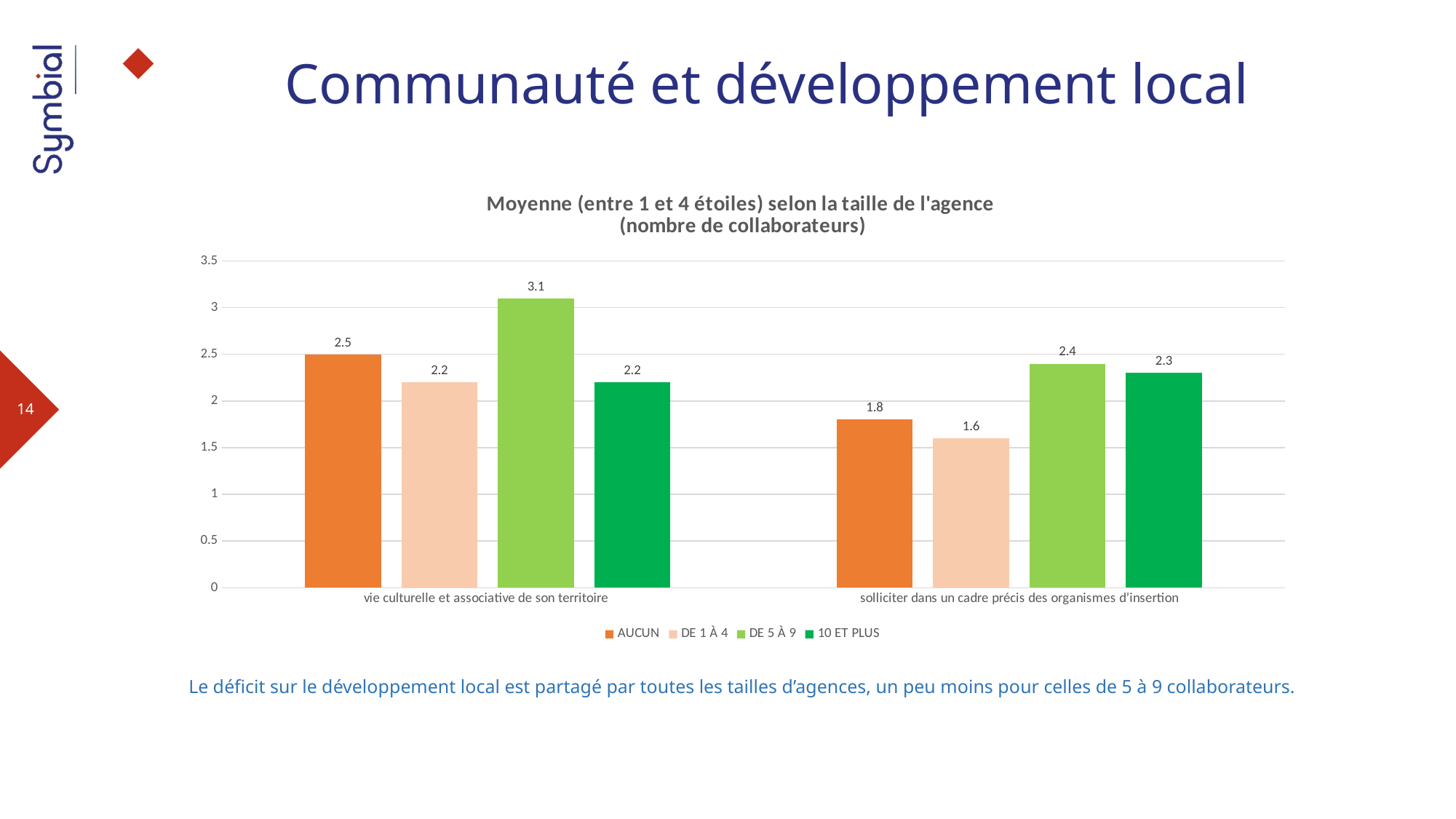
How many series does the legend list? 4 Which is larger: the AUCUN value for 'vie culturelle et associative de son territoire' or the AUCUN value for 'solliciter dans un cadre précis des organismes d'insertion'? vie culturelle et associative de son territoire What is the value for DE 1 À 4 in the category 'solliciter dans un cadre précis des organismes d'insertion'? 1.6 What is the title of the chart? Moyenne (entre 1 et 4 étoiles) selon la taille de l'agence (nombre de collaborateurs) How many categories are shown on the x axis? 2 Which series has the lowest value in the category 'solliciter dans un cadre précis des organismes d'insertion'? DE 1 À 4 Is the value for DE 5 À 9 in 'vie culturelle et associative de son territoire' greater or less than 3? greater What is the value for AUCUN in the category 'solliciter dans un cadre précis des organismes d'insertion'? 1.8 Which series has the highest value in the category 'vie culturelle et associative de son territoire'? DE 5 À 9 What kind of chart is shown on the slide? bar chart What is the value for DE 5 À 9 in the category 'vie culturelle et associative de son territoire'? 3.1 What is the difference between the DE 5 À 9 value and the AUCUN value in the category 'vie culturelle et associative de son territoire'? 0.6